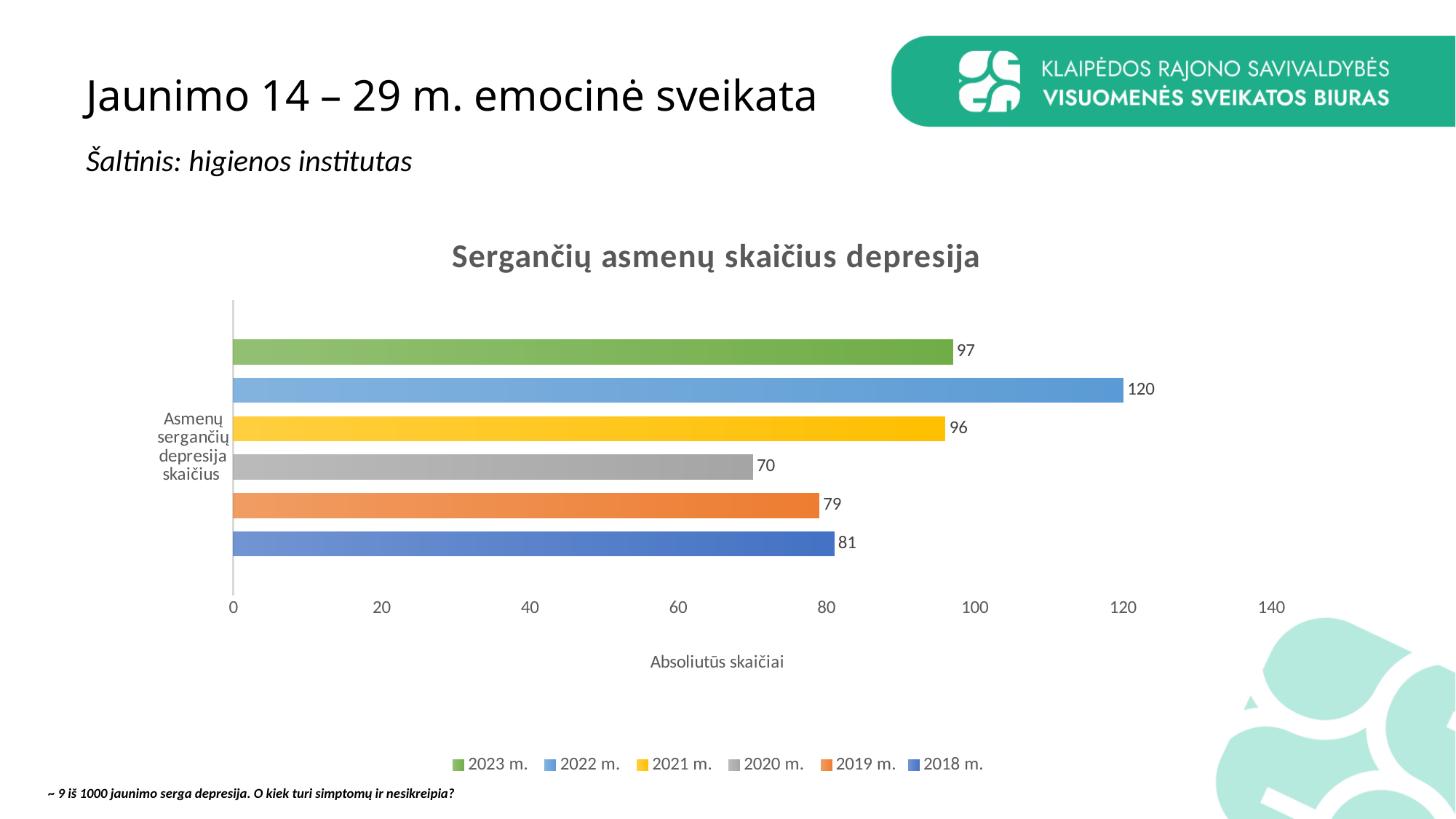
What is the title of the chart? Sergančių asmenų skaičius depresija Which is larger, the value for 2023 m. or the value for 2019 m.? 2023 m. Which year has the lowest value in the chart? 2020 m. What kind of chart is shown on the slide? Bar chart Which year has the highest value in the chart? 2022 m. What is the value for 2023 m. in the chart? 97 What is the value for 2022 m. in the chart? 120 What is the value for 2018 m. in the chart? 81 What is the value for 2020 m. in the chart? 70 What is the difference between the values for 2022 m. and 2021 m.? 24 What is the difference between the values for 2018 m. and 2019 m.? 2 How many series does the legend list? 6